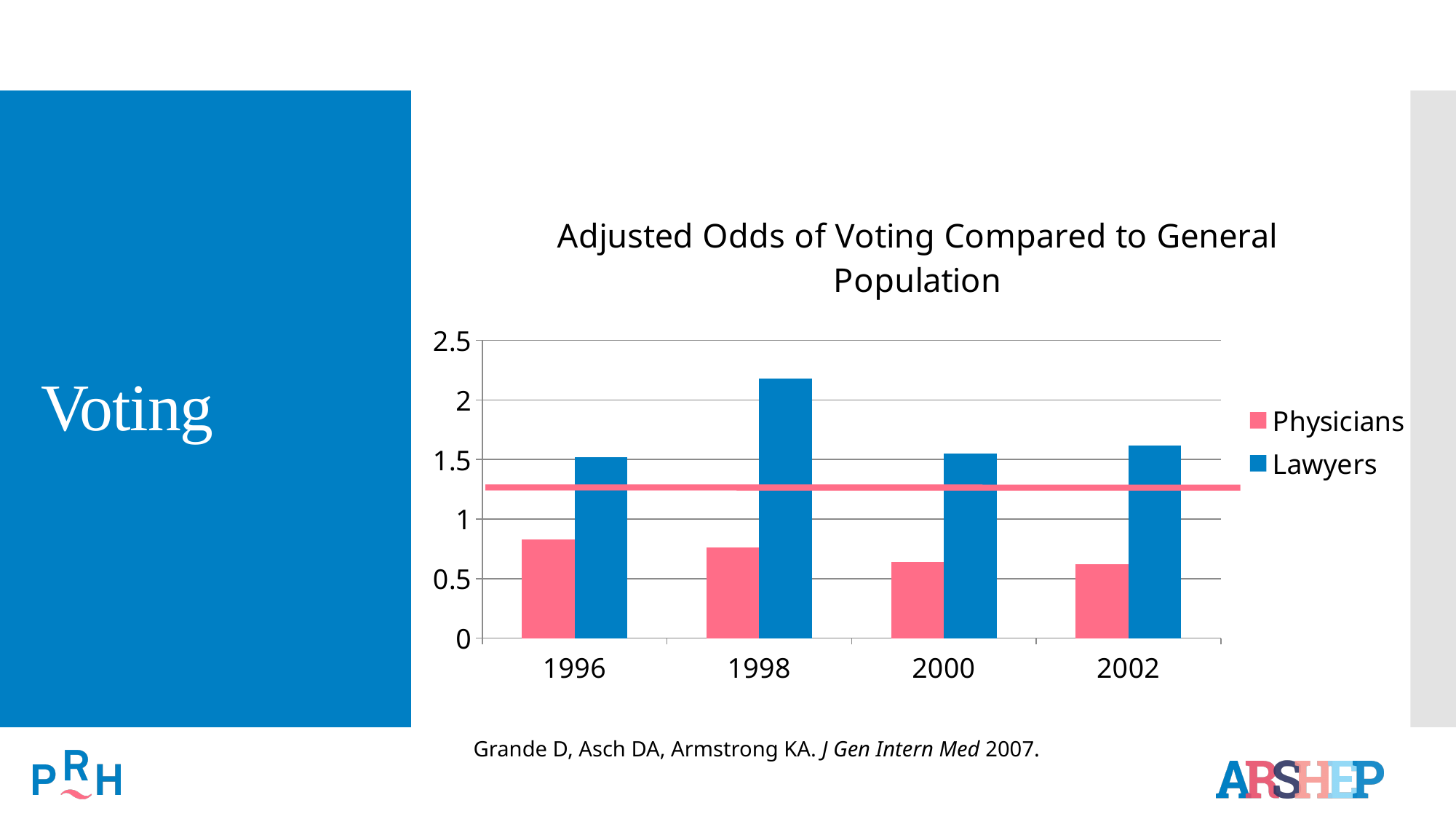
What is the title of the chart? Adjusted Odds of Voting Compared to General Population Is the Lawyers value for 1998 greater or less than 2? greater Is the Physicians value for 1996 greater or less than 1? less What kind of chart is shown on the slide? bar chart In which year is the Lawyers value highest? 1998 How many years are shown on the x axis? 4 How many series does the legend list? 2 Do the Physicians values rise or fall from 1996 to 2002? fall Is the Lawyers value for 2002 greater or less than 1.5? greater Which is larger in 1998, the Physicians value or the Lawyers value? Lawyers In which year is the Physicians value highest? 1996 Which colour represents Lawyers in the legend? blue